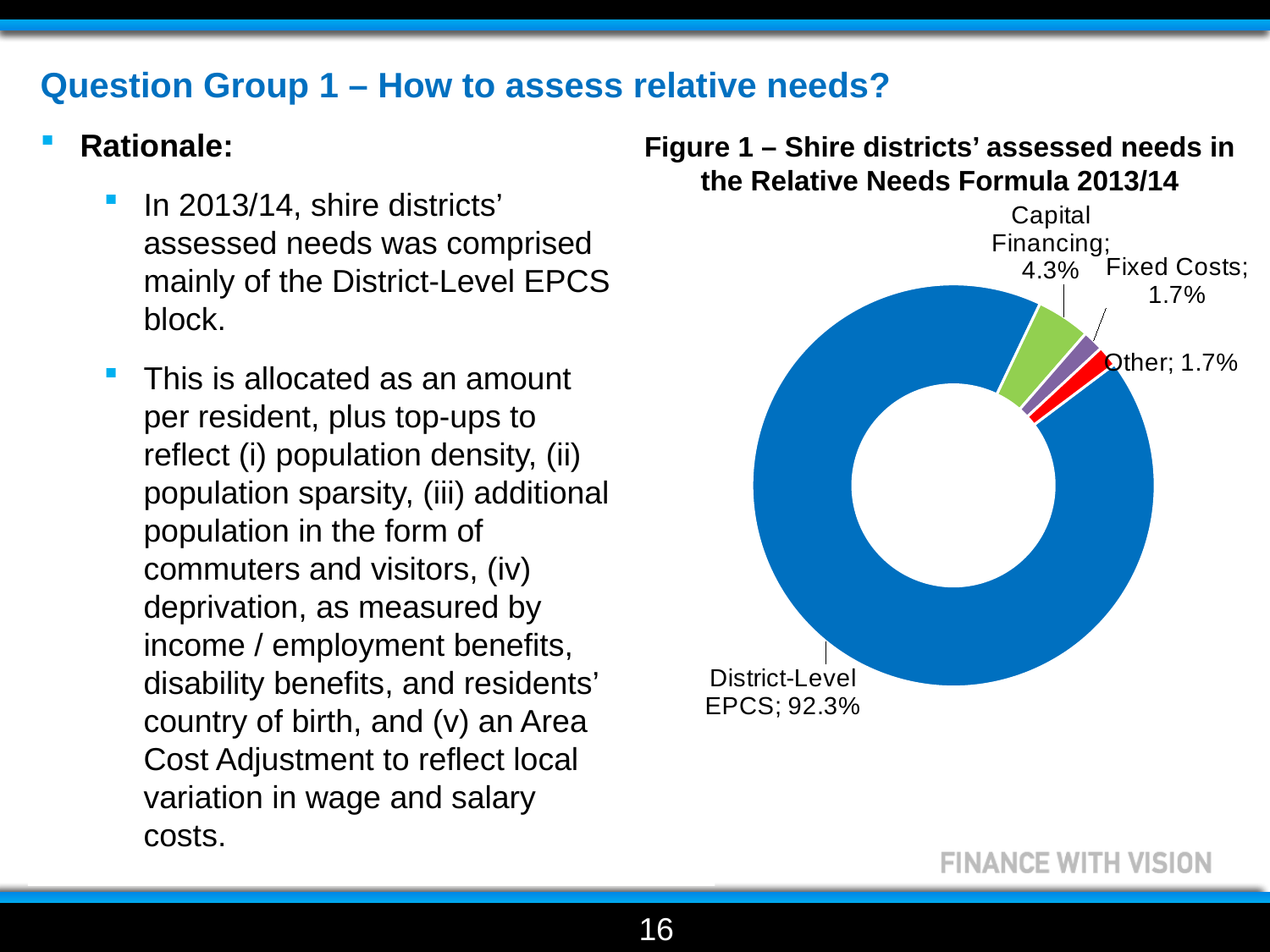
What is the difference in percentage points between District-Level EPCS and Capital Financing? 88.0 percentage points What share of shire districts' assessed needs is District-Level EPCS? 92.3% How many categories are shown in the chart? 4 What is the difference in percentage points between Capital Financing and Fixed Costs? 2.6 percentage points What colour is the District-Level EPCS segment? Blue What share of shire districts' assessed needs is Fixed Costs? 1.7% What kind of chart is shown on the slide? Pie chart (doughnut) Which category has the largest share of the chart? District-Level EPCS What share of shire districts' assessed needs is Other? 1.7% Which is larger, the share for Capital Financing or the share for Fixed Costs? Capital Financing What share of shire districts' assessed needs is Capital Financing? 4.3% What is the title of the chart? Figure 1 – Shire districts' assessed needs in the Relative Needs Formula 2013/14